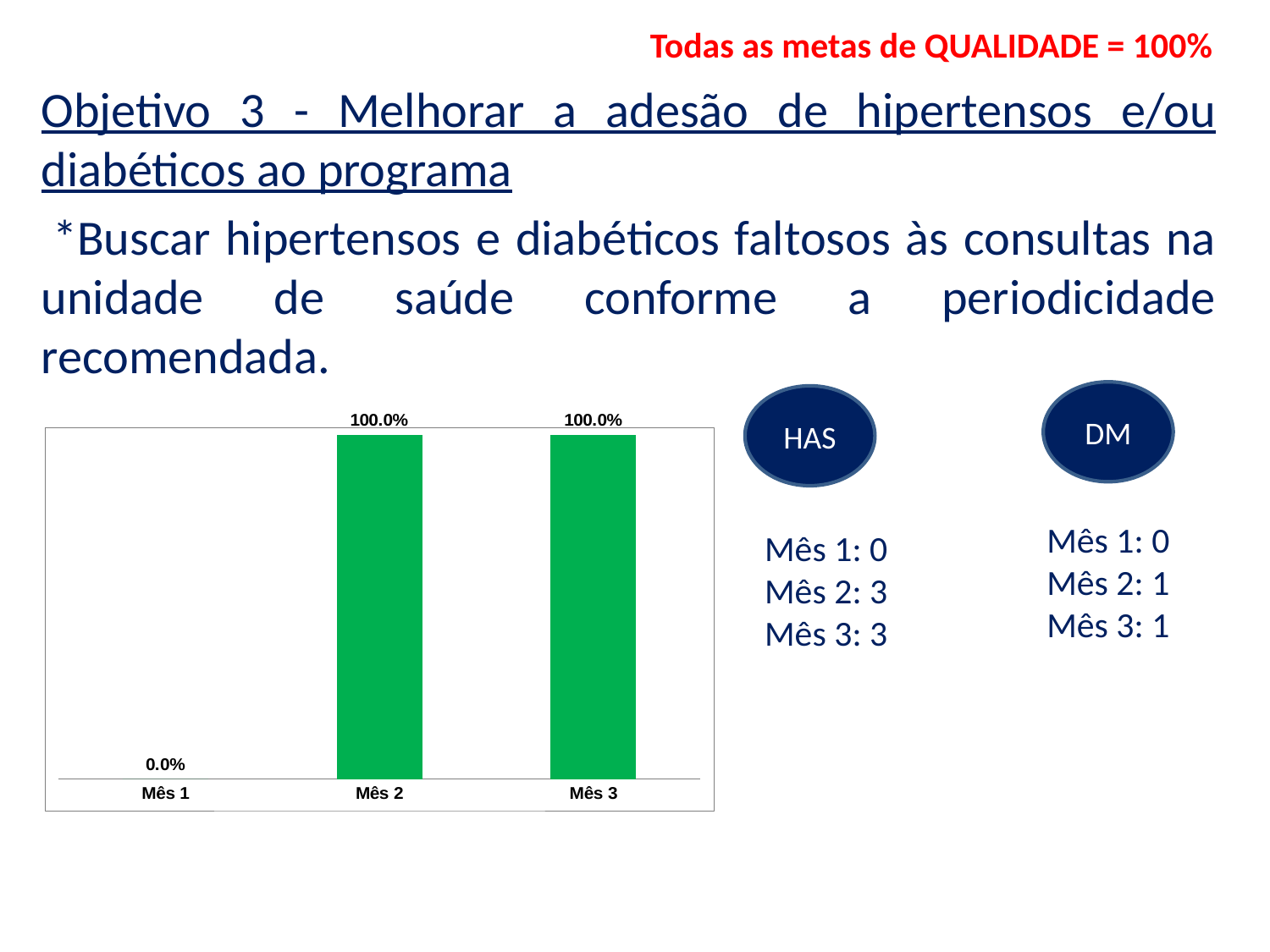
What kind of chart is shown on the slide? Bar chart What is the label of the first category on the x axis of the bar chart? Mês 1 Which is larger in the bar chart, the value for Mês 1 or the value for Mês 3? Mês 3 Which category has the lowest value in the bar chart? Mês 1 What is the difference between the values for Mês 2 and Mês 1 in the bar chart? 100.0% What is the value shown for Mês 3 in the bar chart? 100.0% How many categories are shown on the x axis of the bar chart? 3 What is the value shown for Mês 1 in the bar chart? 0.0% What colour are the bars in the chart? Green What is the value shown for Mês 2 in the bar chart? 100.0% Do the values in the bar chart rise or fall from Mês 1 to Mês 2? Rise